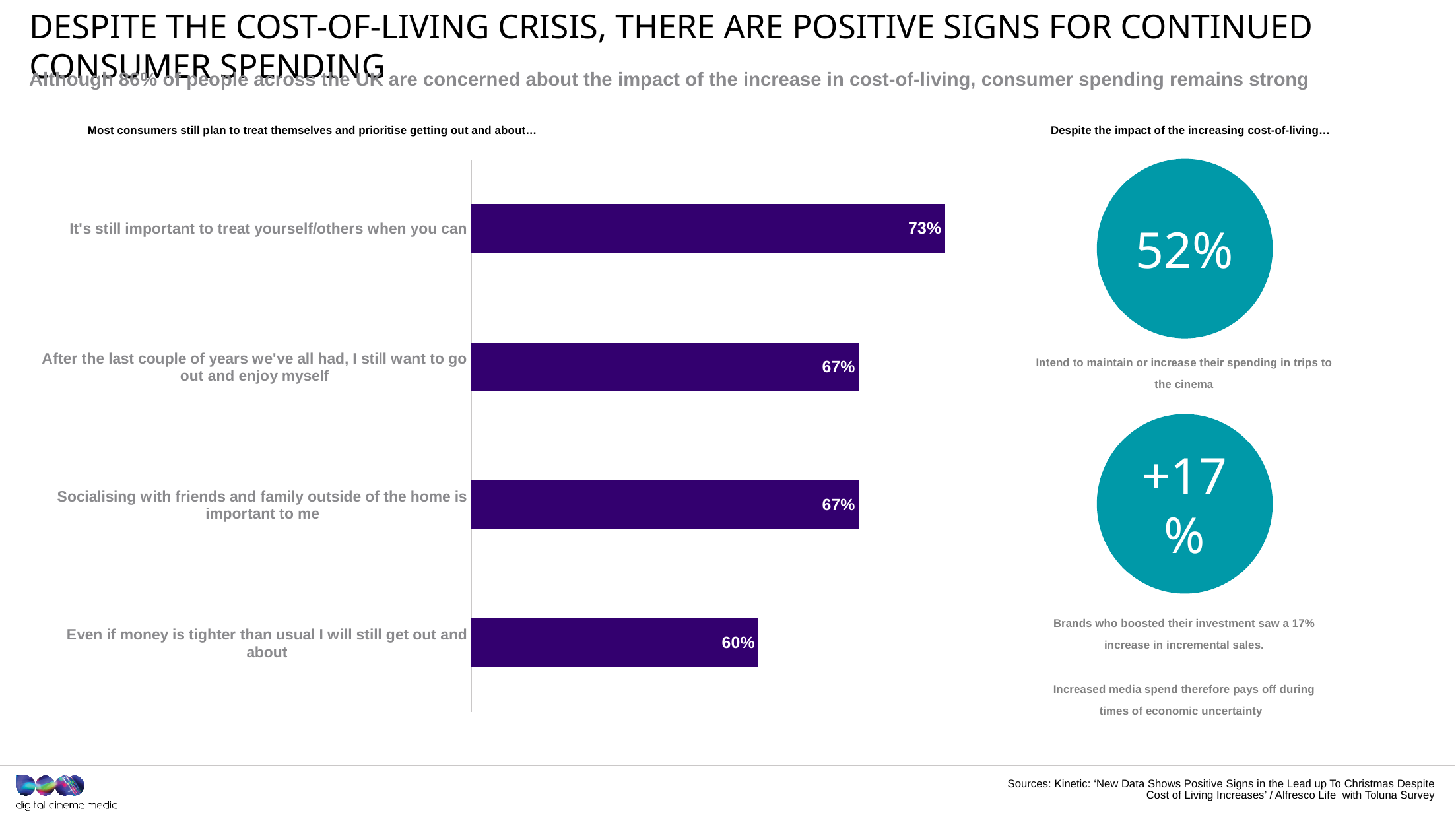
How many statements (bars) are shown in the bar chart? 4 Do the bar values rise or fall from the top bar to the bottom bar? Fall What percentage agree that socialising with friends and family outside of the home is important to them? 67% What is the difference in percentage points between 'It's still important to treat yourself/others when you can' and 'Even if money is tighter than usual I will still get out and about'? 13 percentage points What type of chart is used to show the consumer attitude statements? Bar chart What colour are the bars in the bar chart? Dark purple Which statement has the highest percentage of agreement in the bar chart? It's still important to treat yourself/others when you can What is the value for 'Even if money is tighter than usual I will still get out and about'? 60% What percentage of respondents agree that it's still important to treat yourself/others when you can? 73% What is the title text above the bar chart? Most consumers still plan to treat themselves and prioritise getting out and about… Which statement has the lowest percentage of agreement in the bar chart? Even if money is tighter than usual I will still get out and about Which is larger: the value for 'After the last couple of years we've all had, I still want to go out and enjoy myself' or the value for 'Even if money is tighter than usual I will still get out and about'? After the last couple of years we've all had, I still want to go out and enjoy myself